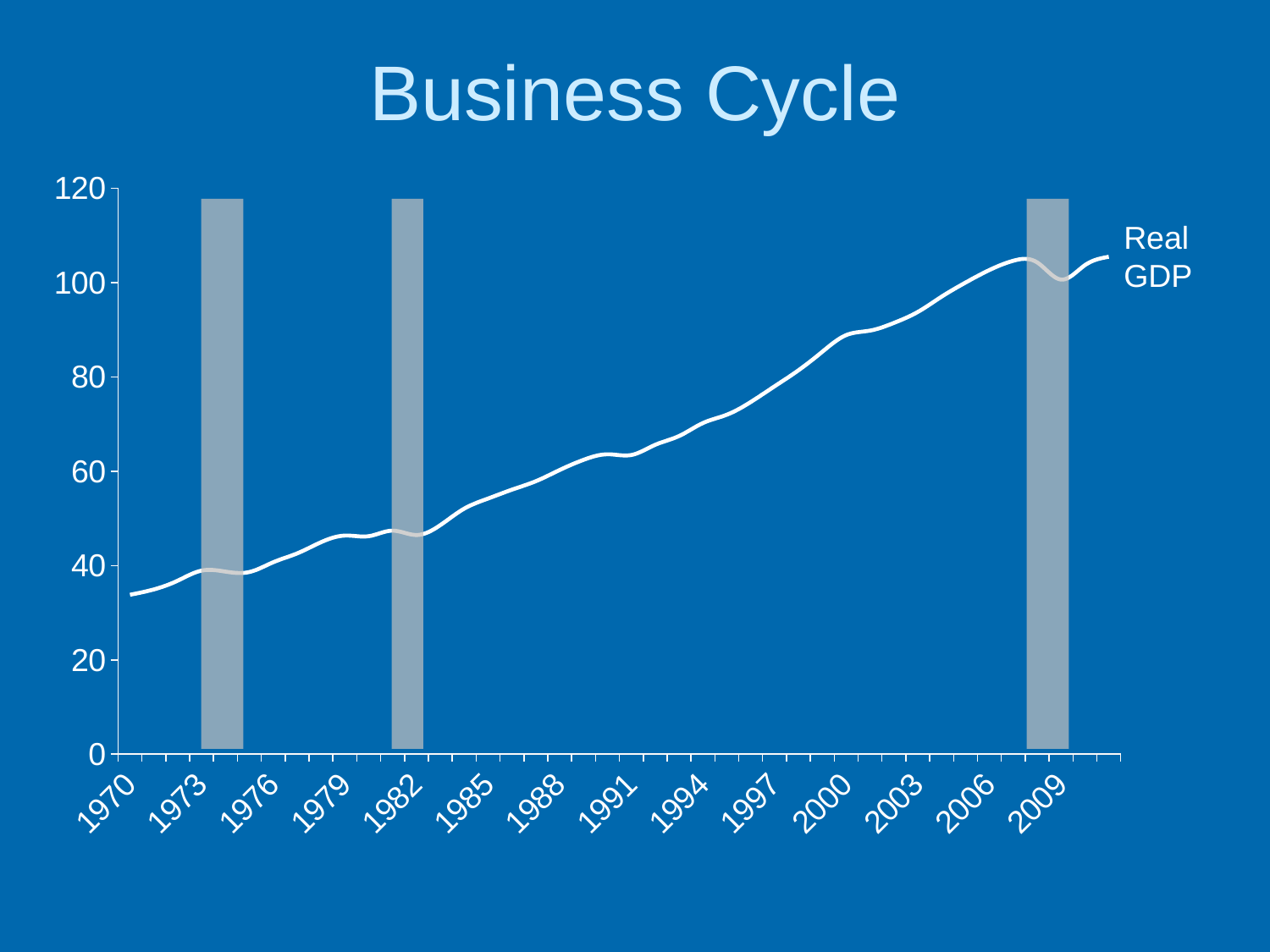
What series is plotted on the chart? Real GDP How many series are plotted on the chart? 1 In which labelled year is Real GDP lowest? 1970 How many year labels are shown on the x axis? 14 What is the title of the chart? Business Cycle Does Real GDP generally rise or fall from 1970 to 2009? rise Is the value of Real GDP in 1982 greater or less than 60? less Which is larger, Real GDP in 1985 or Real GDP in 2000? 2000 Is the value of Real GDP in 1970 greater or less than 40? less What kind of chart is shown on the slide? line chart Is the value of Real GDP in 2006 greater or less than 100? greater